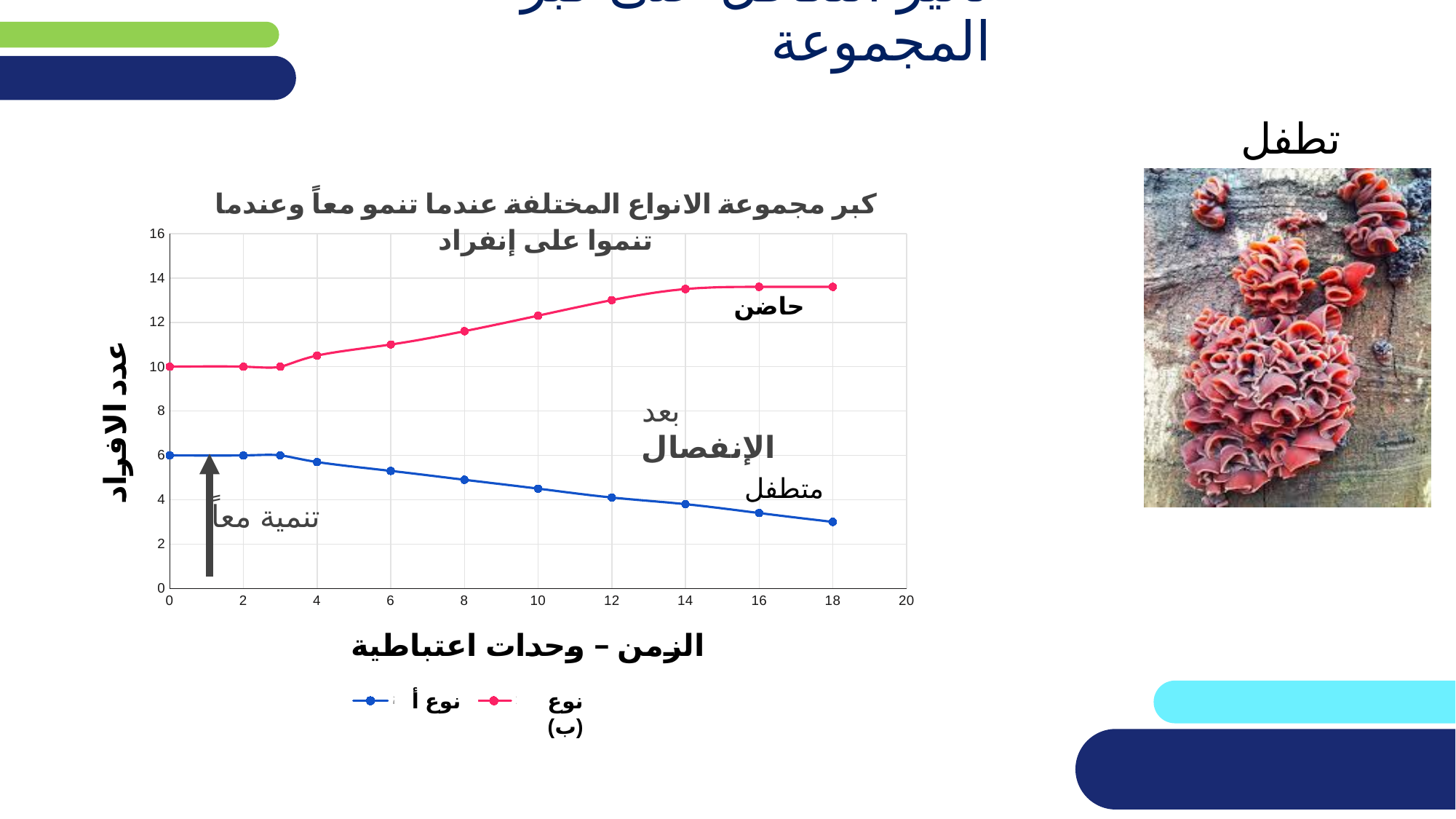
What is the label of the x axis of the chart? الزمن – وحدات اعتباطية What is the label of the y axis of the chart? عدد الافراد Which series has the higher value at time 14, نوع أ or نوع (ب)? نوع (ب) Is the value for نوع (ب) at time 18 greater or less than 12? greater How many series does the chart legend list? 2 What is the value of نوع أ at time 0? 6 What kind of chart is shown on the slide? line chart What is the value of نوع (ب) at time 0? 10 Does the value of نوع أ rise or fall as time increases along the x axis? fall Is the value for نوع أ at time 18 greater or less than 4? less Does the value of نوع (ب) rise or fall as time increases along the x axis? rise